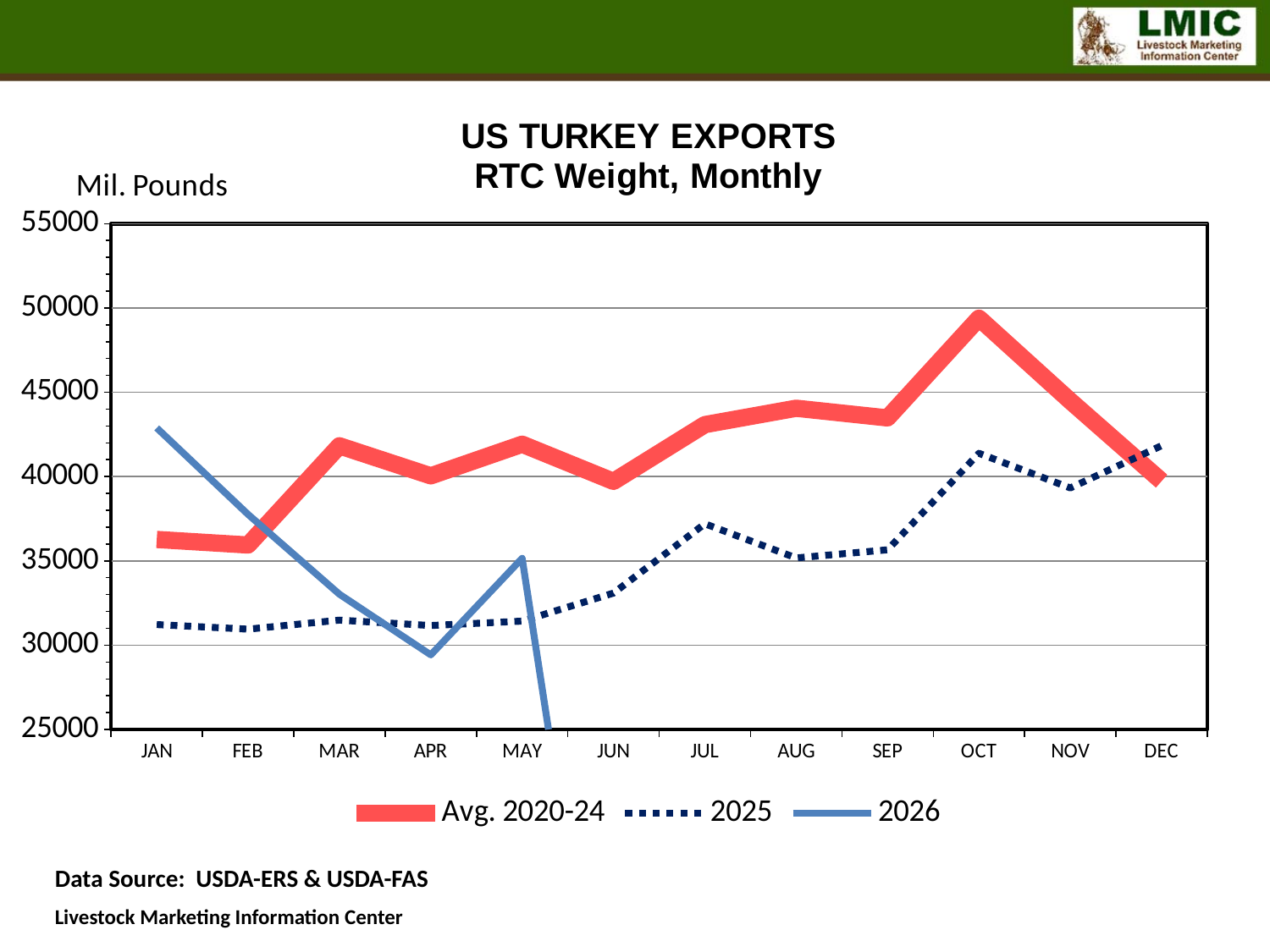
How many series does the legend list? 3 What unit is shown on the y axis label? Mil. Pounds Does the 2026 series rise or fall from JAN to APR? fall In which month does the 2026 series reach its lowest plotted value among JAN through MAY? APR Is the value for 2026 in APR greater or less than 30000? less How many months are shown on the x axis? 12 Is the value for 2025 in JAN greater or less than 35000? less What type of chart is shown on the slide? line chart In which month does the Avg. 2020-24 series reach its highest value? OCT In JUL, which series has the larger value, Avg. 2020-24 or 2025? Avg. 2020-24 In which month does the 2026 series reach its highest value? JAN Is the value for Avg. 2020-24 in OCT greater or less than 45000? greater